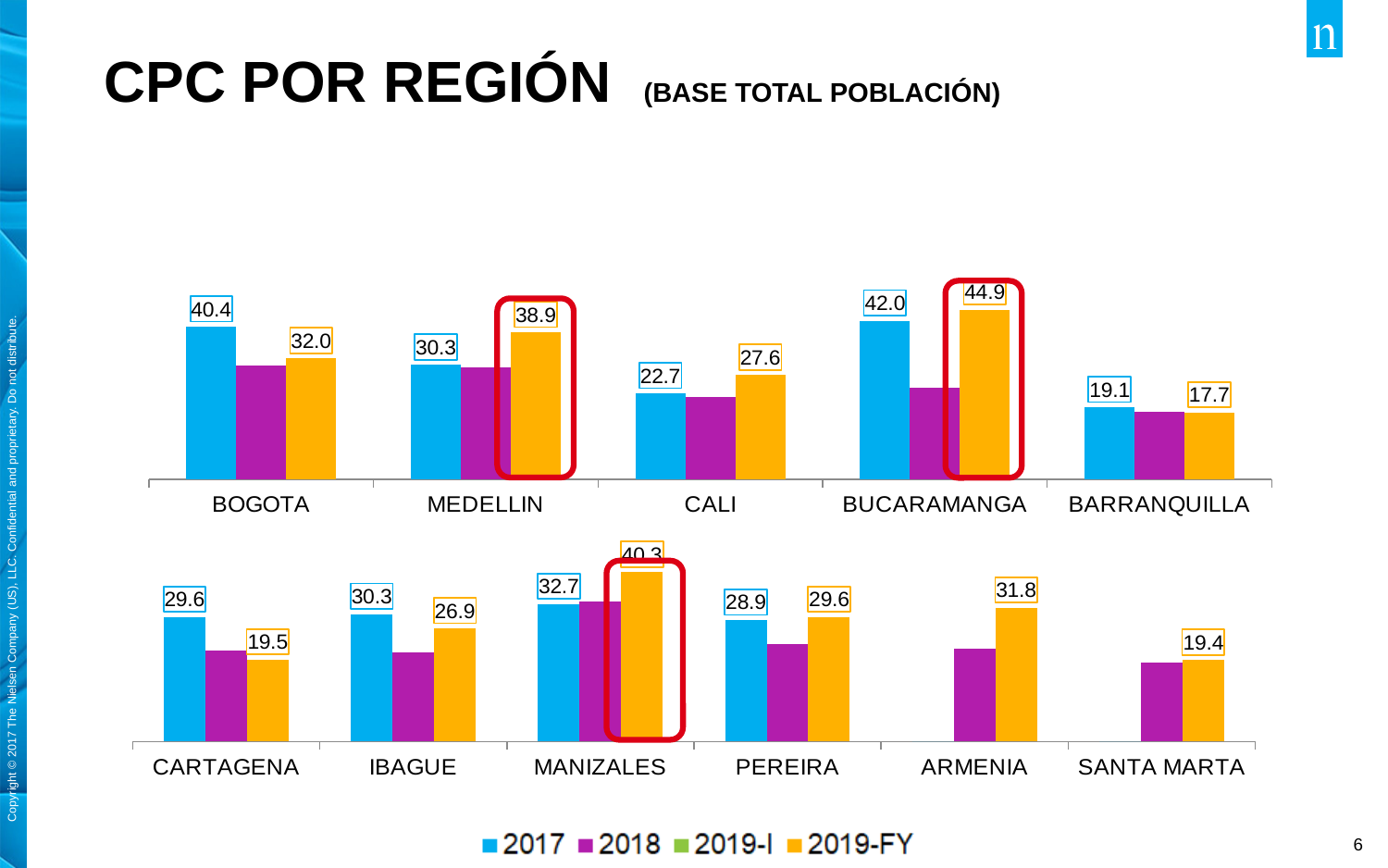
How many series does the legend list? 4 What kind of chart is shown on the slide? Bar chart In the top chart, what is the 2019-FY value for MEDELLIN? 38.9 In the top chart, what is the 2017 value for BOGOTA? 40.4 In the top chart, which region has the highest 2019-FY value? BUCARAMANGA In the top chart, what is the difference between the 2019-FY and 2017 values for MEDELLIN? 8.6 In the bottom chart, what is the 2019-FY value for ARMENIA? 31.8 In the bottom chart, which region has the highest 2019-FY value? MANIZALES In the bottom chart, what is the difference between the 2017 and 2019-FY values for CARTAGENA? 10.1 In the top chart, which is larger for CALI: the 2017 value or the 2019-FY value? 2019-FY How many regions are shown in the bottom chart? 6 In the top chart, which region has the lowest 2017 value? BARRANQUILLA